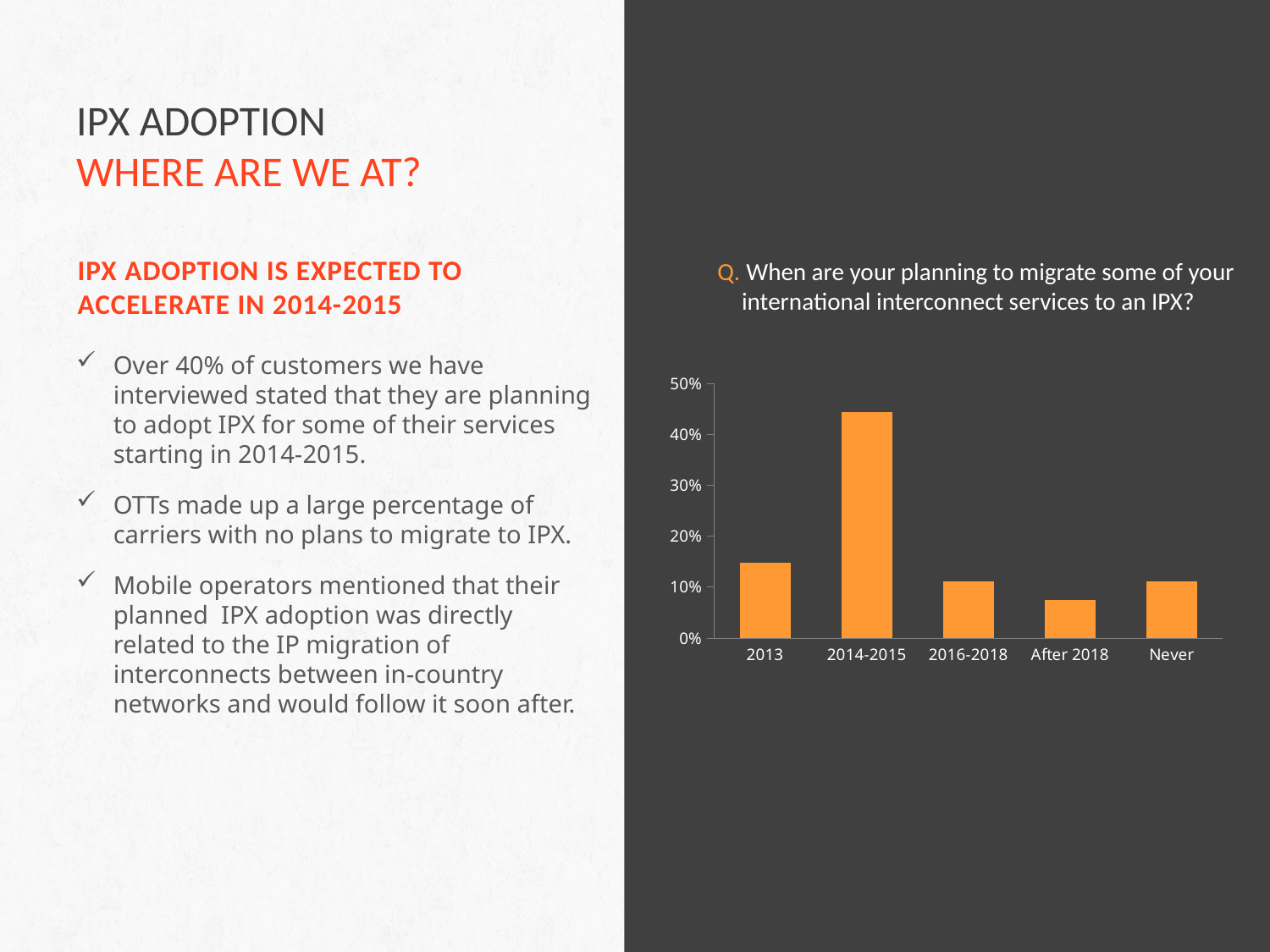
How many categories are shown on the x axis of the chart? 5 Is the value for 2013 greater or less than 20%? less What is the highest value shown on the chart's y axis? 50% Is the value for Never greater or less than 20%? less Is the value for 2014-2015 greater or less than 40%? greater Which is larger, the value for 2013 or the value for After 2018? 2013 Which category has the highest value in the chart? 2014-2015 What kind of chart is shown on the slide? bar chart Which is larger, the value for 2014-2015 or the value for Never? 2014-2015 Which category has the lowest value in the chart? After 2018